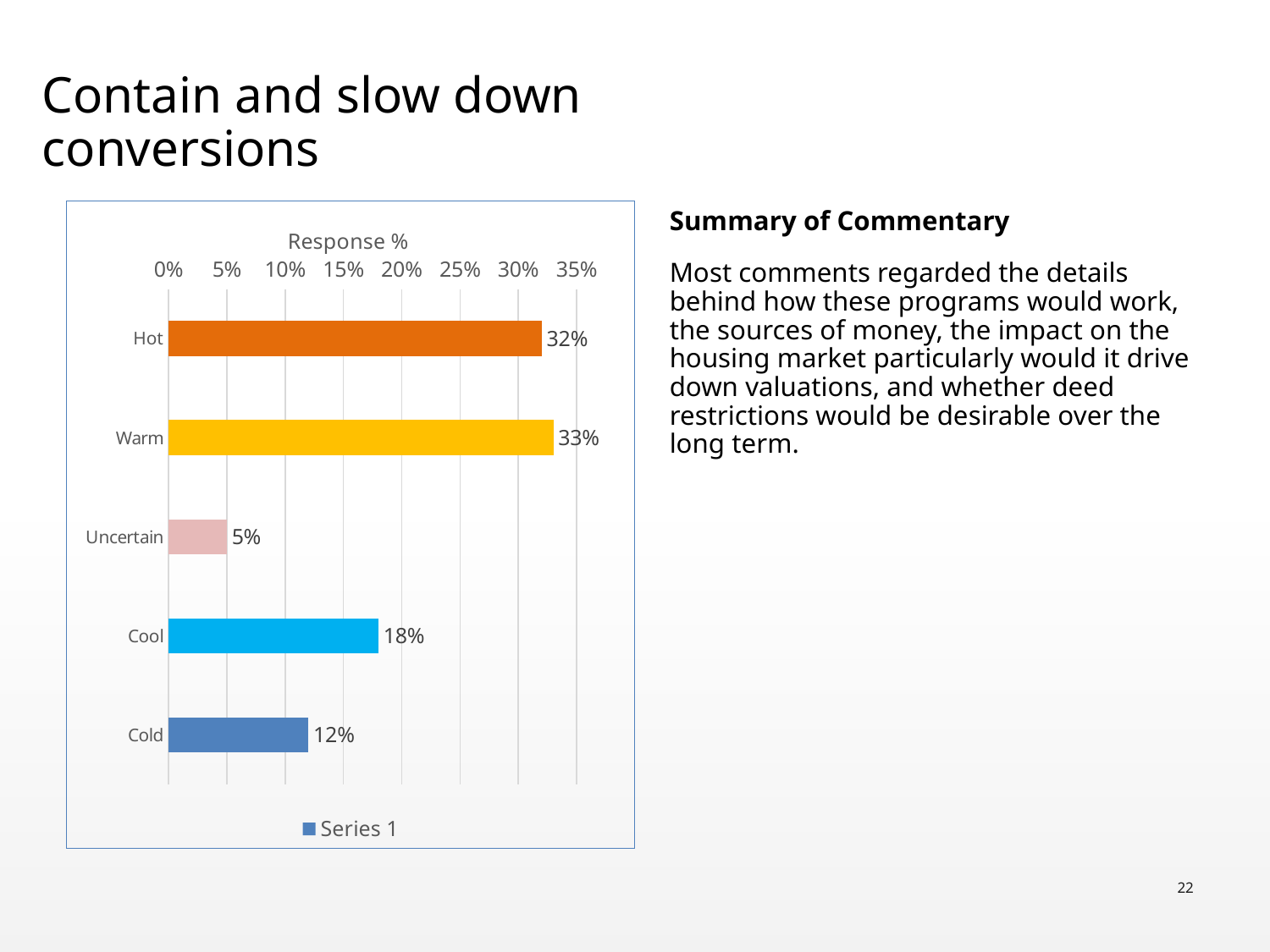
What is the Response % value for Cold? 12% What is the title of the chart? Response % What kind of chart is shown on the slide? Bar chart Which category has the lowest Response %? Uncertain What is the difference between the Response % for Cool and Cold? 6% Is the value for Warm greater or less than 30%? greater Which has a larger Response %, Cool or Cold? Cool What is the Response % value for Hot? 32% What is the Response % value for Uncertain? 5% How many categories are shown in the chart? 5 What is the Response % value for Cool? 18% Which category has the highest Response %? Warm